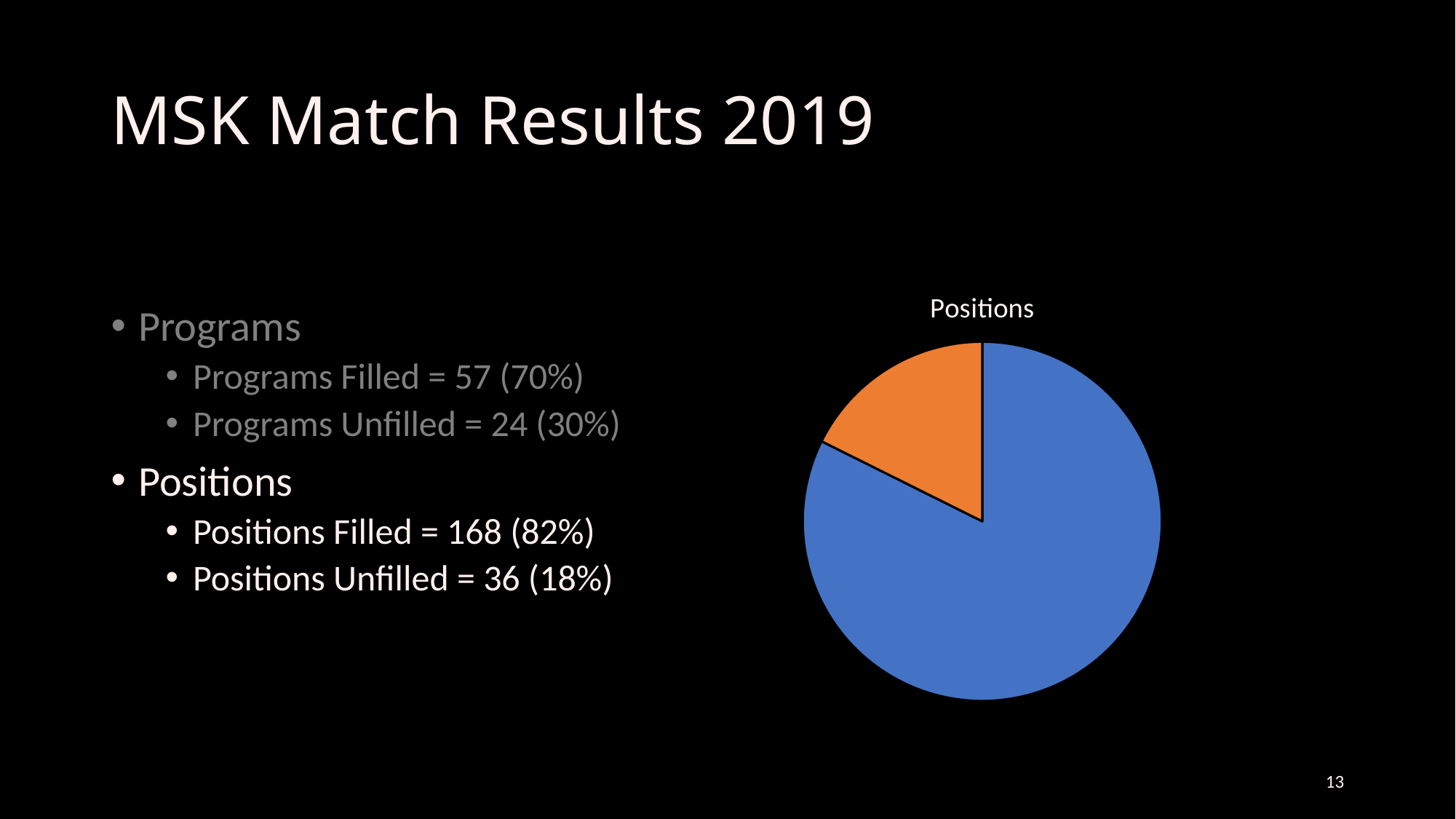
What is the total number of positions represented by the whole pie? 204 What kind of chart is shown on the slide? pie chart How many positions does the larger (blue) slice of the pie represent, according to the slide? 168 What share of the pie does the larger (blue) slice, representing Positions Filled, take? 82% What share of the pie does the smaller (orange) slice, representing Positions Unfilled, take? 18% How many positions does the smaller (orange) slice of the pie represent, according to the slide? 36 Which colour slice is the smallest in the pie chart? orange What is the title of the pie chart? Positions How many slices does the pie chart have? 2 Which colour slice is the largest in the pie chart? blue Is the blue slice larger or smaller than the orange slice? larger What is the difference between the number of positions filled and positions unfilled shown in the pie? 132